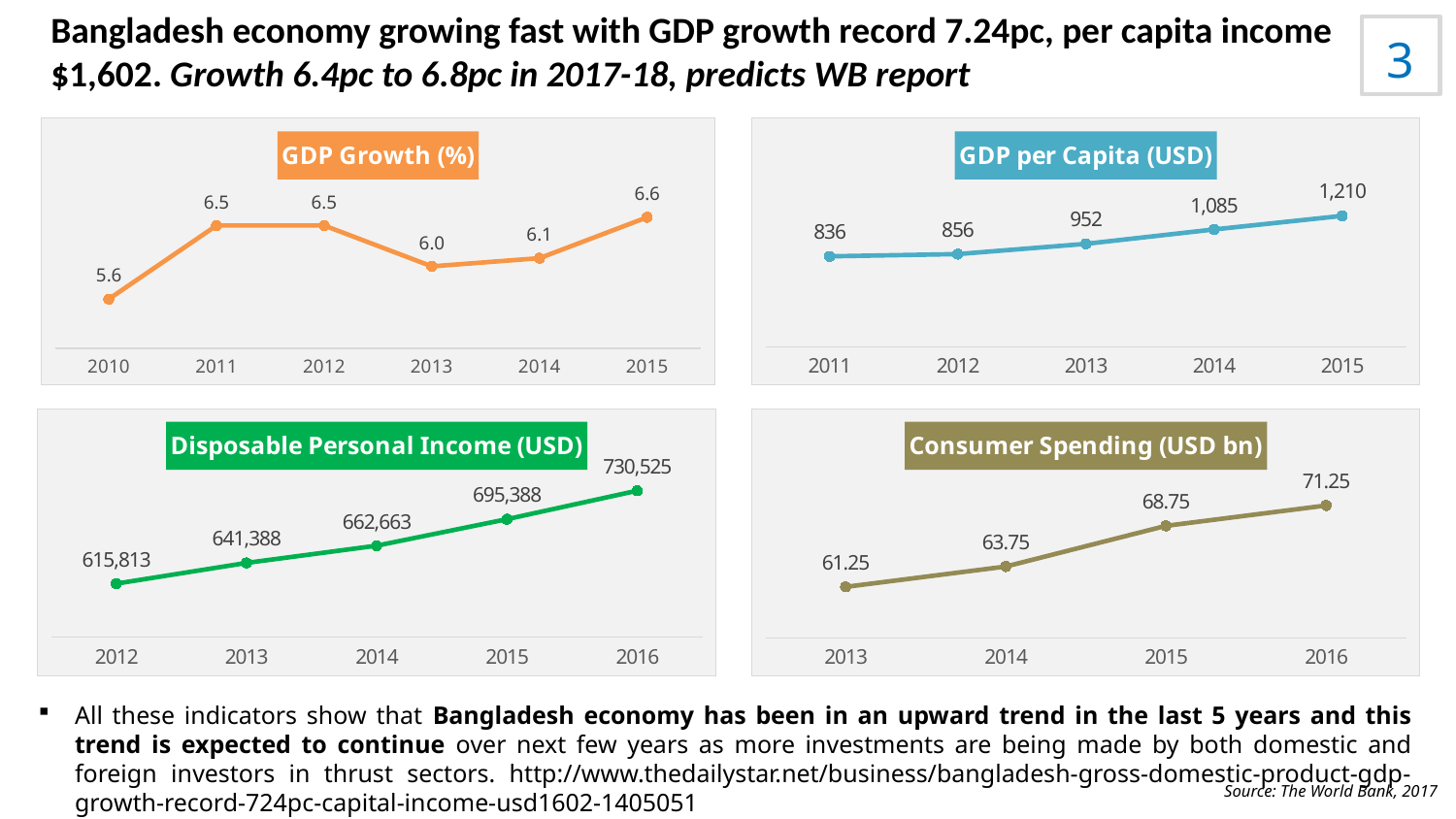
In the GDP Growth (%) chart, which is larger, the value for 2013 or the value for 2014? 2014 In the Disposable Personal Income (USD) chart, what is the value for 2014? 662,663 In the GDP per Capita (USD) chart, what is the difference between the 2015 and 2011 values? 374 In the GDP Growth (%) chart, how many years are plotted? 6 What type of chart is the Consumer Spending (USD bn) chart? line chart In the GDP Growth (%) chart, which year has the highest value? 2015 In the Consumer Spending (USD bn) chart, what is the value for 2015? 68.75 In the GDP per Capita (USD) chart, what is the value for 2014? 1,085 In the GDP Growth (%) chart, what is the value for 2010? 5.6 In the GDP per Capita (USD) chart, do the values rise or fall from 2011 to 2015? rise In the Disposable Personal Income (USD) chart, which year has the lowest value? 2012 In the Consumer Spending (USD bn) chart, what is the difference between the 2016 and 2013 values? 10